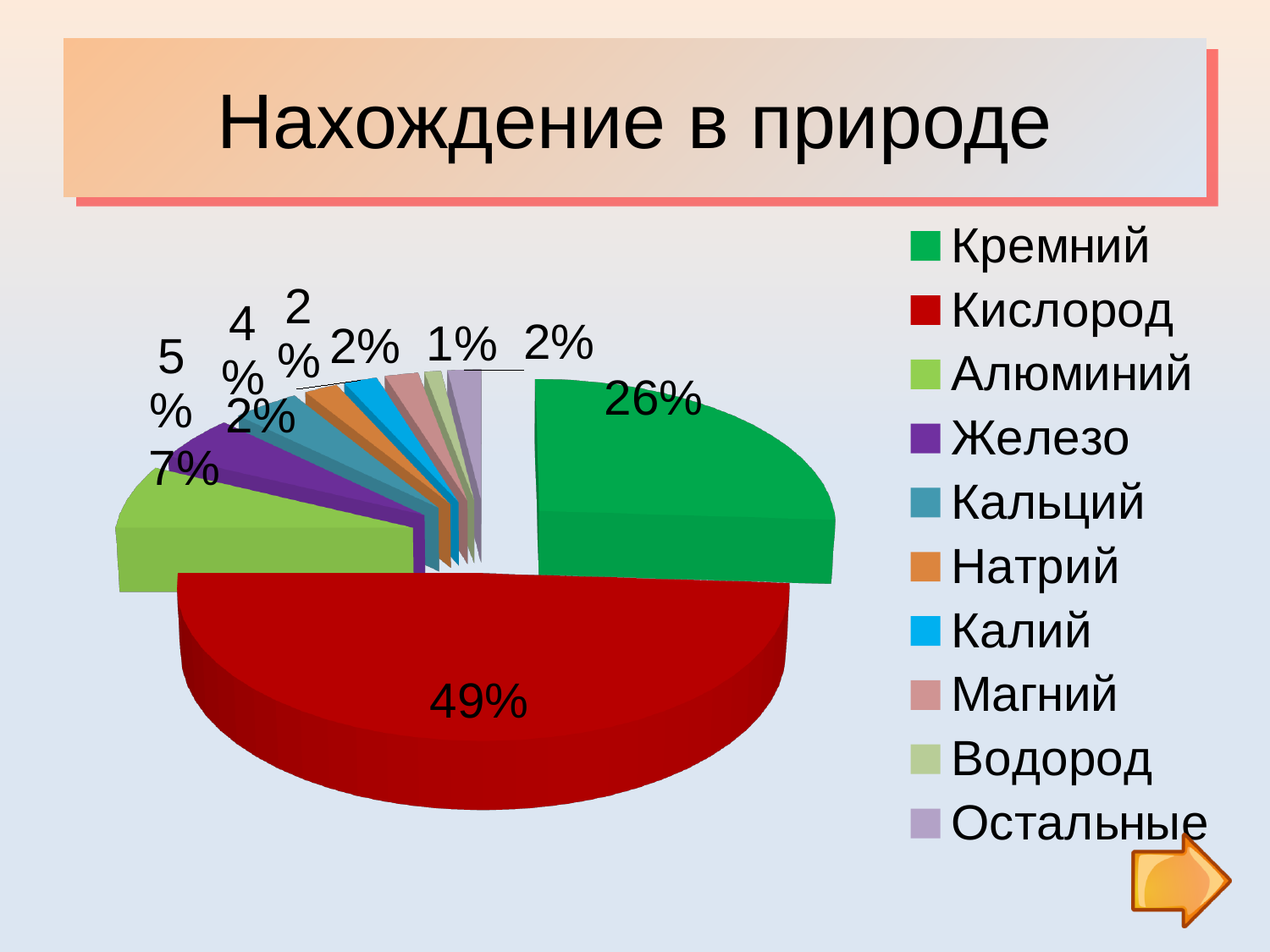
What share of the pie does Алюминий have? 7% What is the difference between the shares of Кислород and Кремний? 23% Which category has the largest slice of the pie? Кислород What share of the pie does Кислород have? 49% What is the title of the slide? Нахождение в природе What is the combined share of Кислород and Кремний? 75% Which category has the smallest slice of the pie? Водород Which is larger, the slice for Кремний or the slice for Алюминий? Кремний How many categories does the legend list? 10 What share of the pie does Кремний have? 26% What kind of chart is shown on the slide? pie chart What colour is the slice for Кислород? red